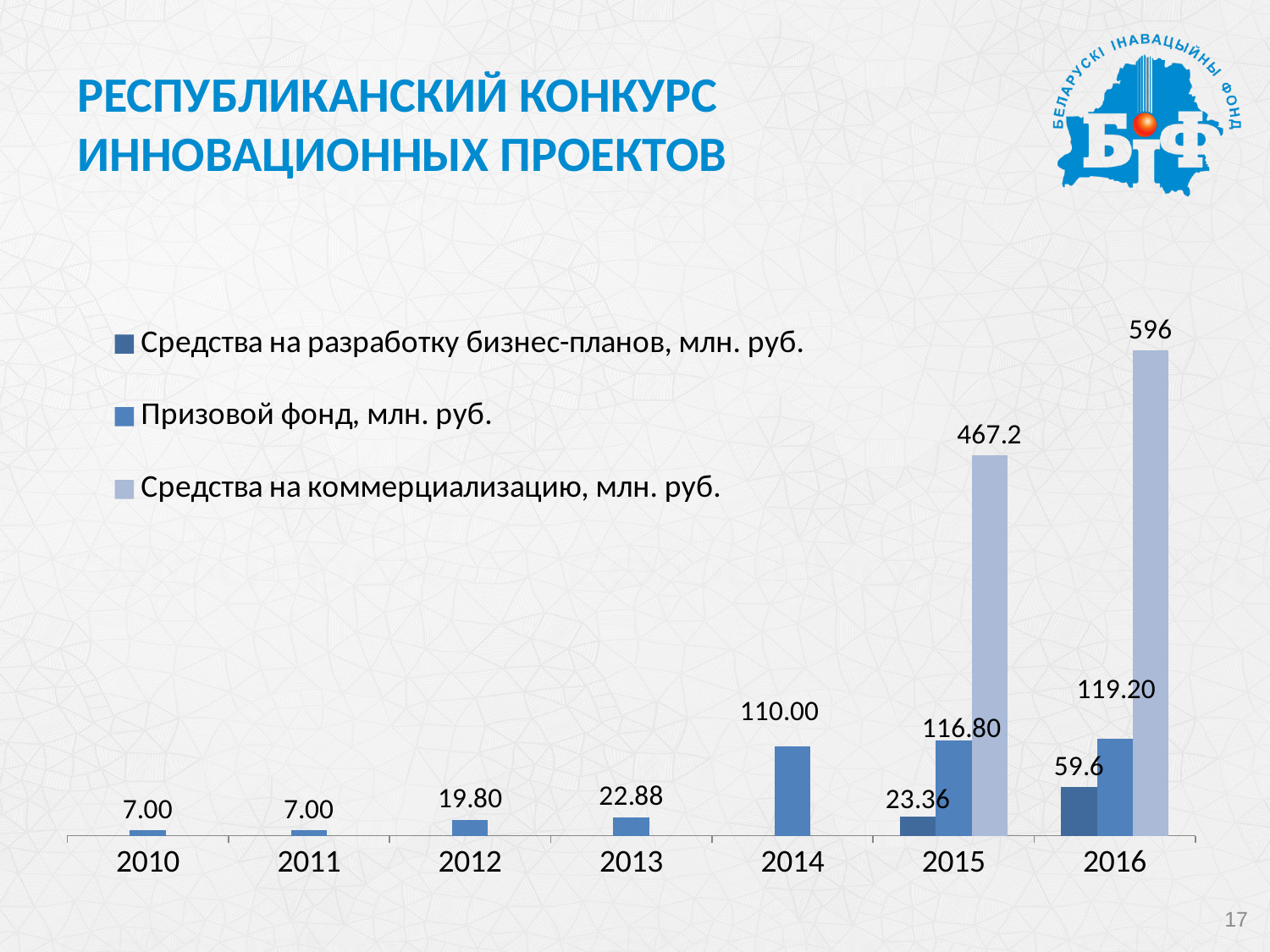
What kind of chart is shown on the slide? Bar chart Which is larger: Призовой фонд, млн. руб. in 2016 or in 2015? 2016 Which year has the highest value for Средства на коммерциализацию, млн. руб.? 2016 What is the difference between Средства на коммерциализацию, млн. руб. in 2016 and in 2015? 128.8 How many years are shown on the x axis? 7 What is the value of Средства на коммерциализацию, млн. руб. for 2016? 596 What is the value of Призовой фонд, млн. руб. for 2014? 110.00 What is the value of Средства на разработку бизнес-планов, млн. руб. for 2015? 23.36 Which year has the lowest value for Призовой фонд, млн. руб.? 2010 and 2011 How many series does the legend list? 3 What is the value of Призовой фонд, млн. руб. for 2013? 22.88 Does the value of Призовой фонд, млн. руб. rise or fall from 2010 to 2016? Rise